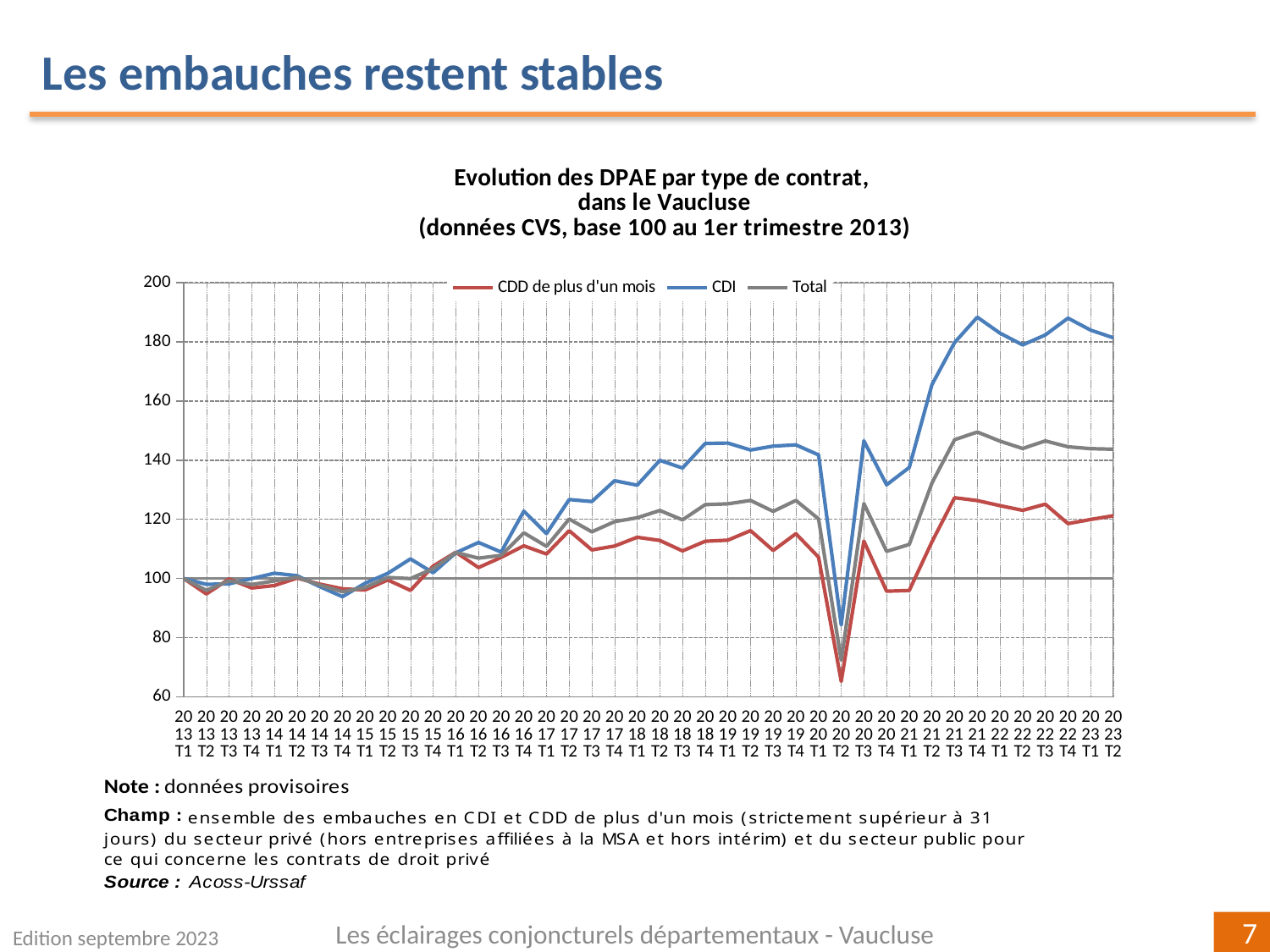
Is the value of the Total series at 2023 T2 greater or less than 120? greater At 2023 T2, which series has the higher value, CDI or CDD de plus d'un mois? CDI What is the value of the CDI series at 2013 T1? 100 Is the value of the CDI series at 2023 T2 greater or less than 160? greater Does the CDI series rise or fall between 2020 T2 and 2021 T4? rise In which quarter does the CDI series reach its lowest value? 2020 T2 How many quarterly points are plotted along the x axis? 42 What kind of chart is shown on the slide? line chart Is the value of the CDD de plus d'un mois series at 2020 T2 greater or less than 80? less What colour is the CDI line in the chart? blue How many series does the legend list? 3